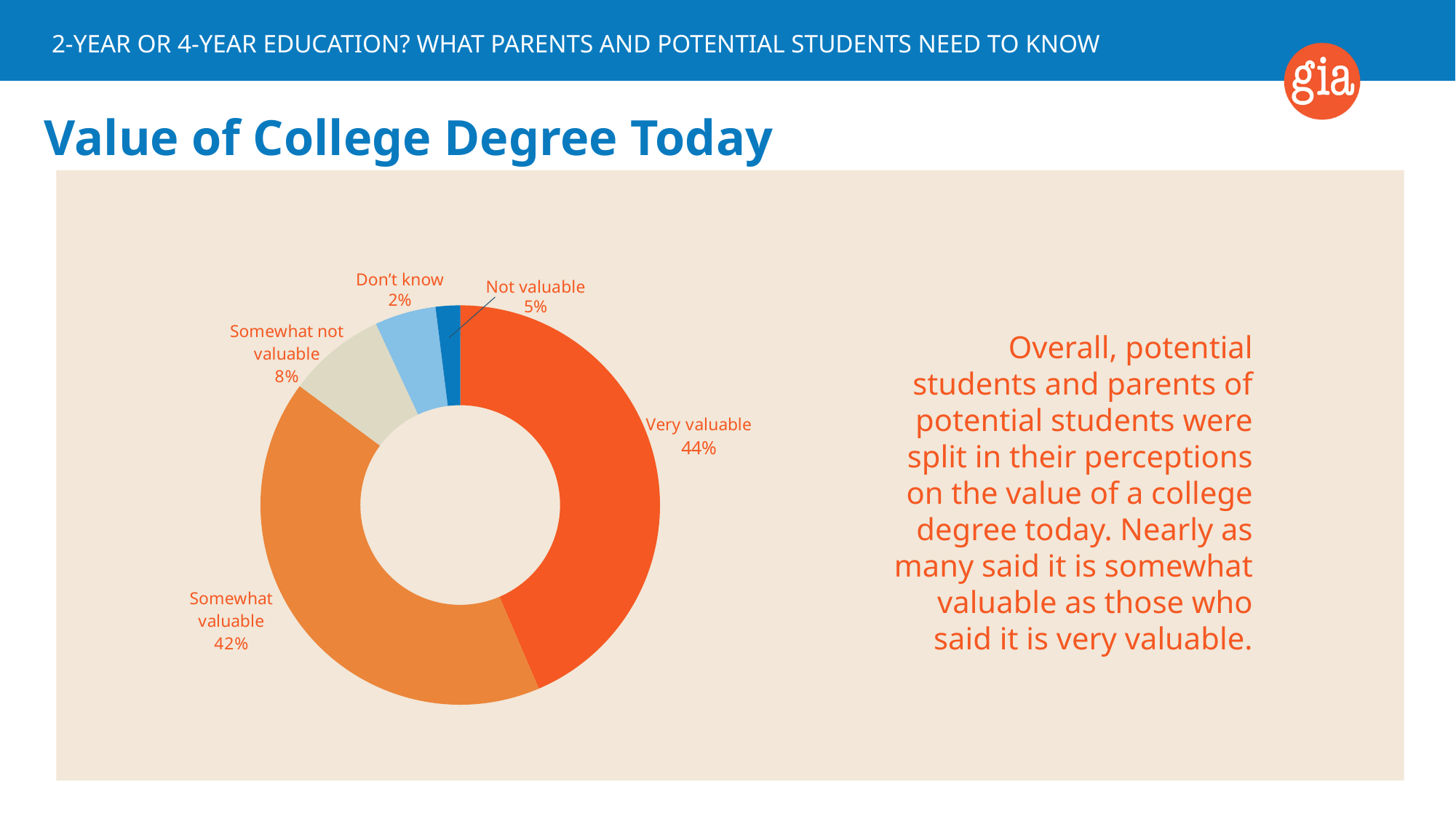
How many categories are shown in the chart? 5 What kind of chart is shown on the slide? Doughnut chart Which category has the smallest share of the chart? Don't know Which category has the largest share of the chart? Very valuable What percentage of respondents said a college degree is very valuable? 44% What is the title of the chart on the slide? Value of College Degree Today What percentage of respondents answered 'Don't know'? 2% What percentage of respondents said a college degree is not valuable? 5% What is the difference in percentage points between 'Very valuable' and 'Somewhat valuable'? 2 What percentage of respondents said a college degree is somewhat valuable? 42% What percentage of respondents said a college degree is somewhat not valuable? 8% Which is larger, the share for 'Somewhat not valuable' or the share for 'Not valuable'? Somewhat not valuable